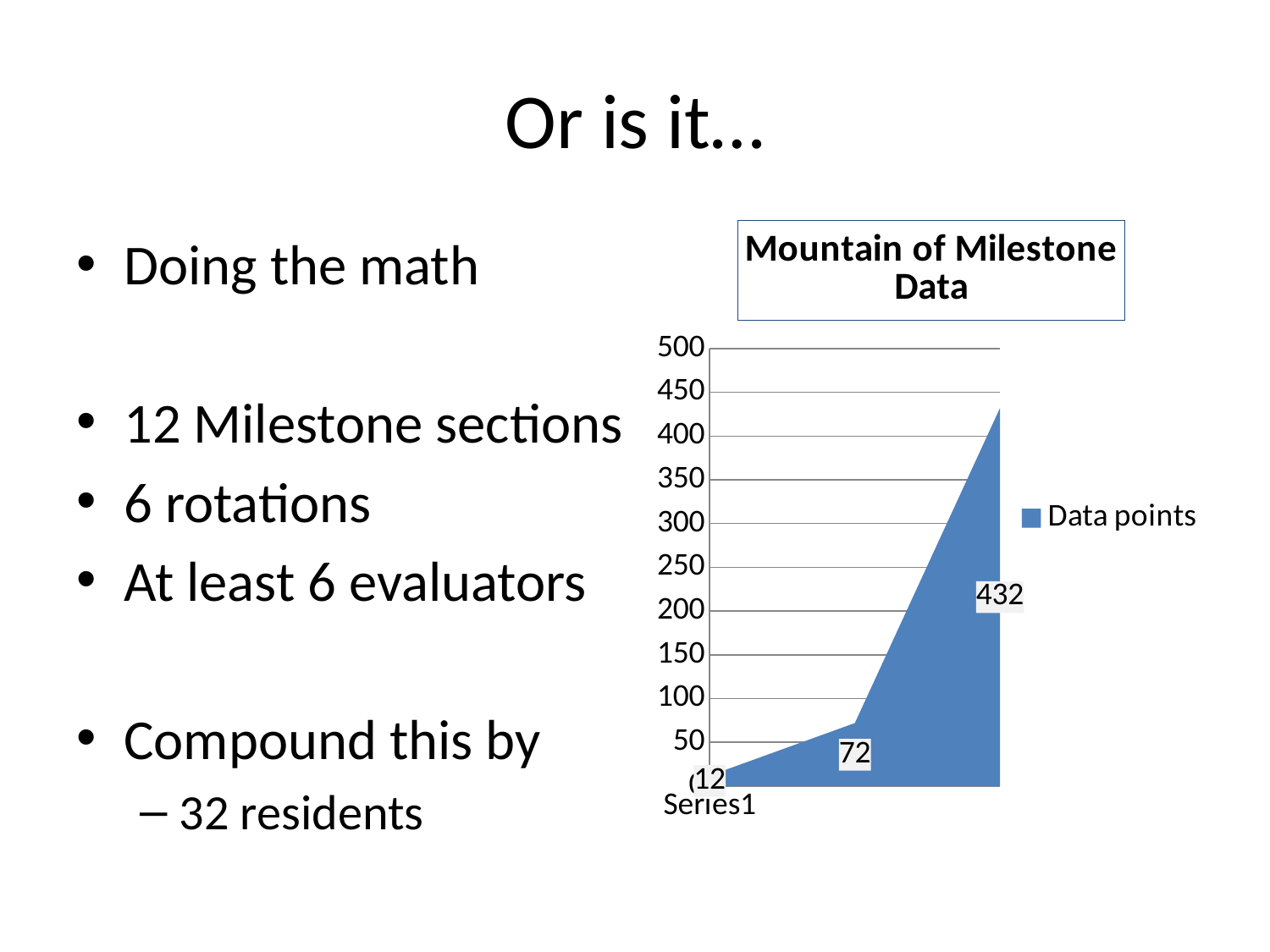
What is the difference between the last data point (432) and the second data point (72)? 360 What is the lowest value plotted in the chart? 12 What is the highest value plotted in the chart? 432 Do the values rise or fall from left to right along the x axis? rise What is the value of the third (last) data point in the chart? 432 What type of chart is shown on the slide? area chart What is the title of the chart? Mountain of Milestone Data What is the name of the series shown in the chart legend? Data points What is the value of the second data point in the chart? 72 How many data points are plotted in the chart? 3 What is the value of the first data point in the chart? 12 How many series does the chart legend list? 1